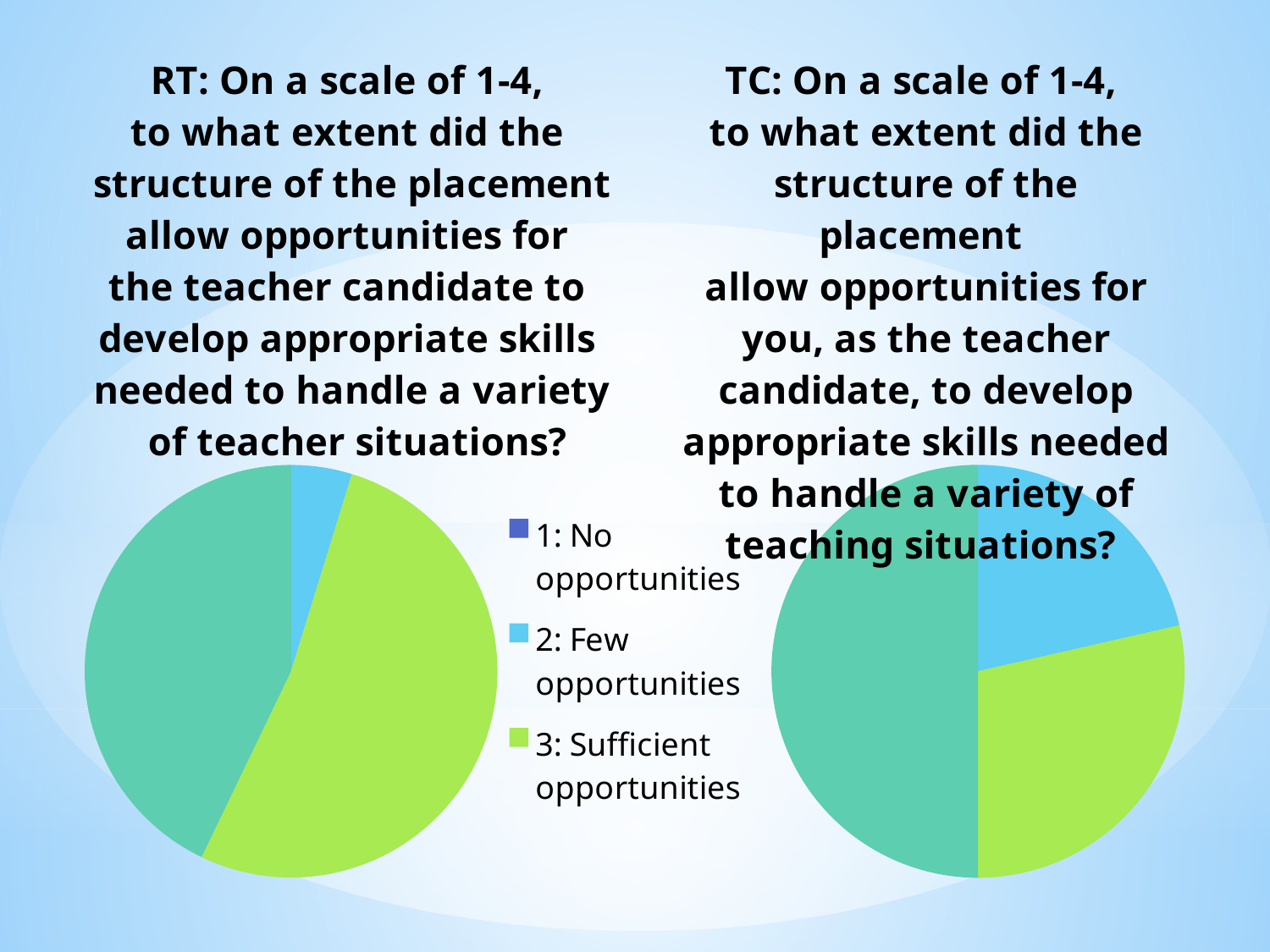
How many pie charts are shown on the slide? 2 In the TC pie chart on the right, which is larger: the slice for "3: Sufficient opportunities" or the slice for "2: Few opportunities"? 3: Sufficient opportunities What kind of chart is used on the right side of the slide (the TC chart)? Pie chart In the RT pie chart on the left, which legend category has the smallest visible slice? 2: Few opportunities In the RT pie chart on the left, which is larger: the slice for "3: Sufficient opportunities" or the slice for "2: Few opportunities"? 3: Sufficient opportunities What kind of chart is used on the left side of the slide (the RT chart)? Pie chart In the TC pie chart on the right, which legend category has the smallest visible slice? 2: Few opportunities What colour does the legend use for "3: Sufficient opportunities"? Green How many entries does the legend between the two pie charts list? 3 What colour does the legend use for "2: Few opportunities"? Light blue